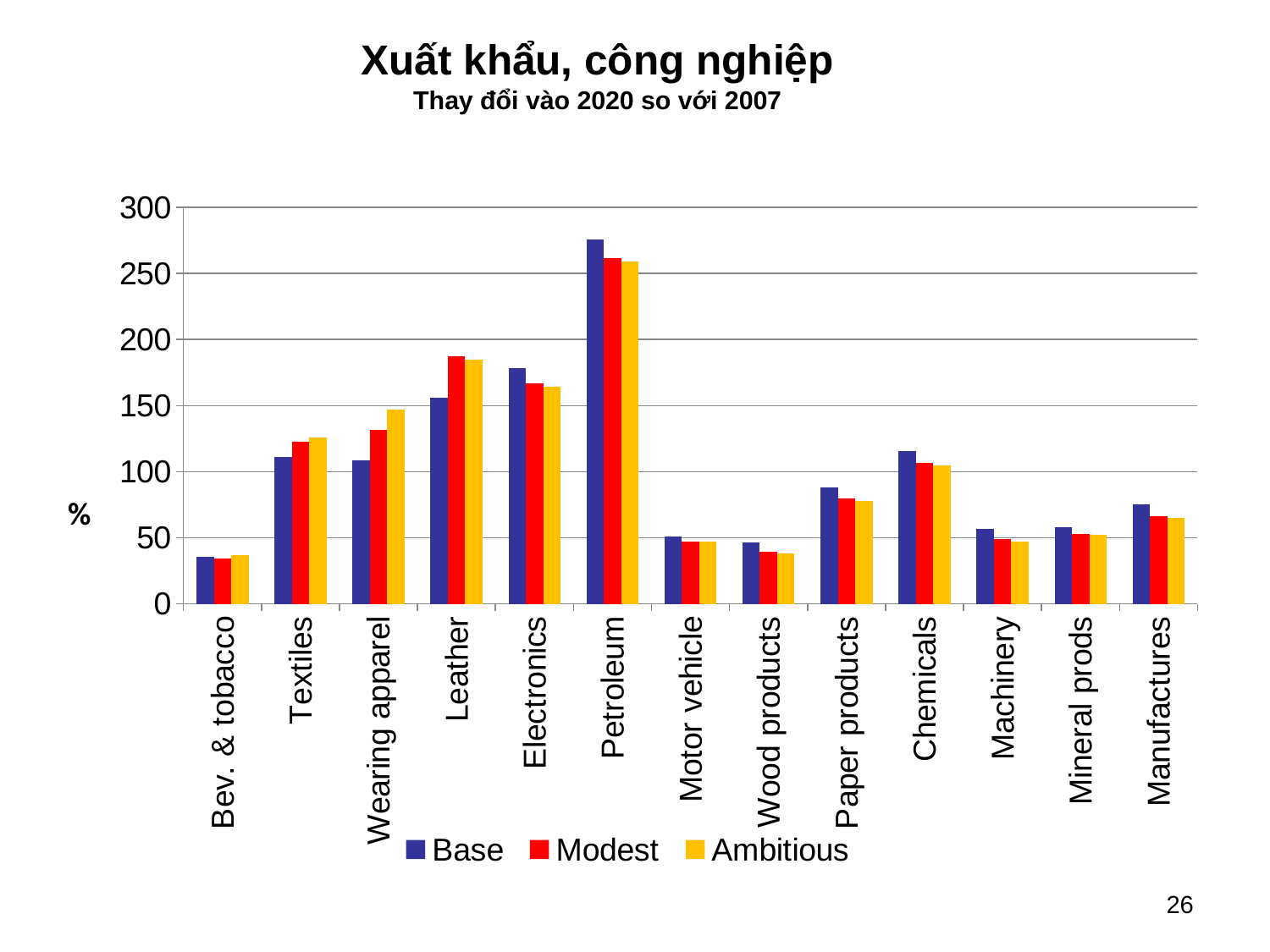
How many categories are shown on the x axis? 13 Which category has the highest value for the Base series? Petroleum Which category has the lowest value for the Base series? Bev. & tobacco Which is larger for the Base series: Leather or Electronics? Electronics What kind of chart is shown on the slide? bar chart Is the Modest value for Leather greater or less than 150? greater Is the Base value for Petroleum greater or less than 250? greater Is the Base value for Paper products greater or less than 100? less What is the title of the chart? Xuất khẩu, công nghiệp For Wearing apparel, which series has the larger value: Base or Ambitious? Ambitious How many series does the legend list? 3